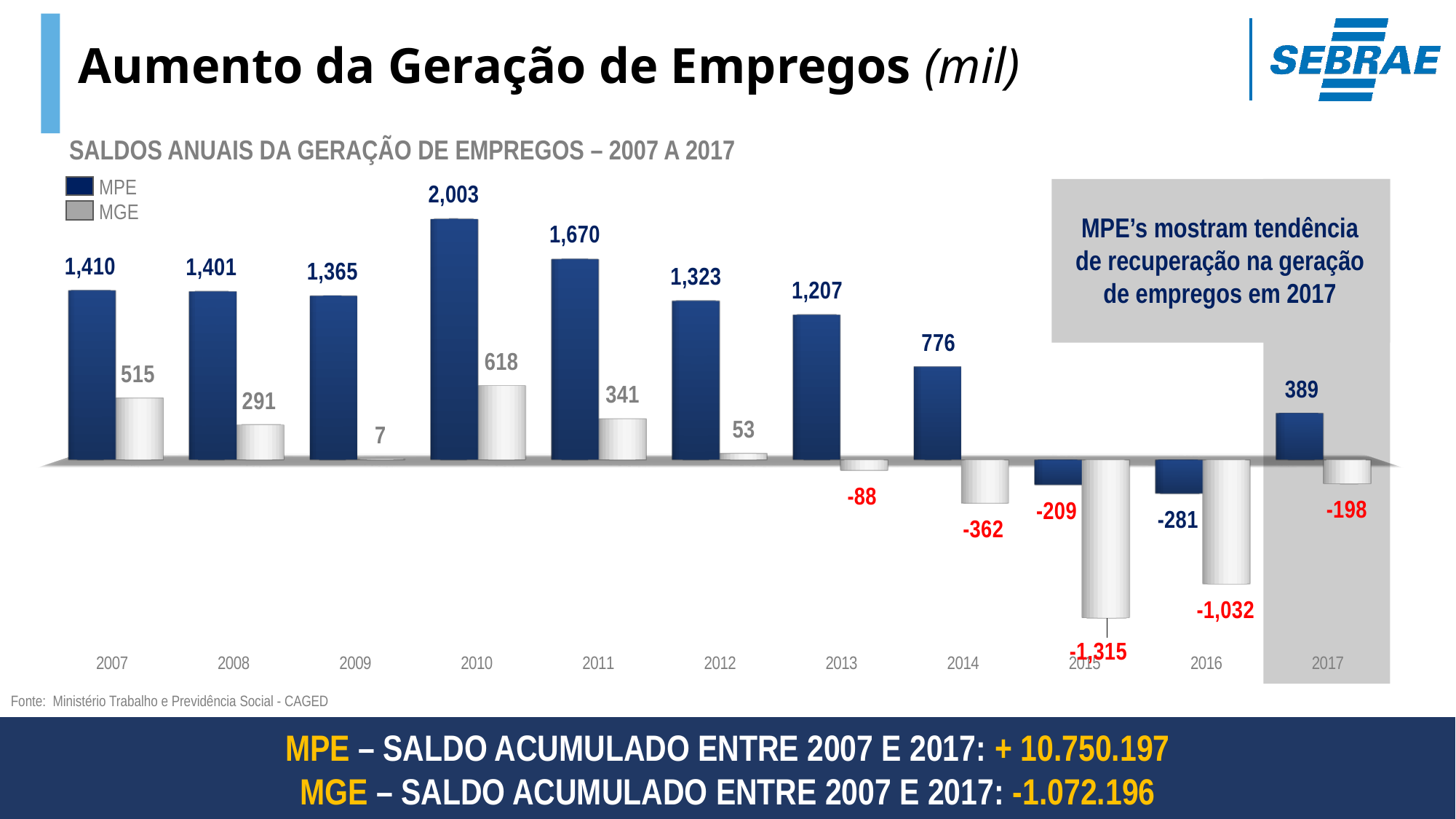
How many series does the legend list? 2 What is the MPE value for 2017? 389 How many years are shown on the x axis? 11 In which year is the MGE value lowest? 2015 In which year is the MPE value highest? 2010 What is the subtitle of the chart? SALDOS ANUAIS DA GERAÇÃO DE EMPREGOS – 2007 A 2017 What is the difference between the MPE and MGE values in 2010? 1,385 What kind of chart is shown on the slide? Bar chart What is the MPE value for 2010? 2,003 What is the MGE value for 2009? 7 What is the MGE value for 2015? -1,315 Which is larger, the MPE value for 2011 or the MPE value for 2012? 2011